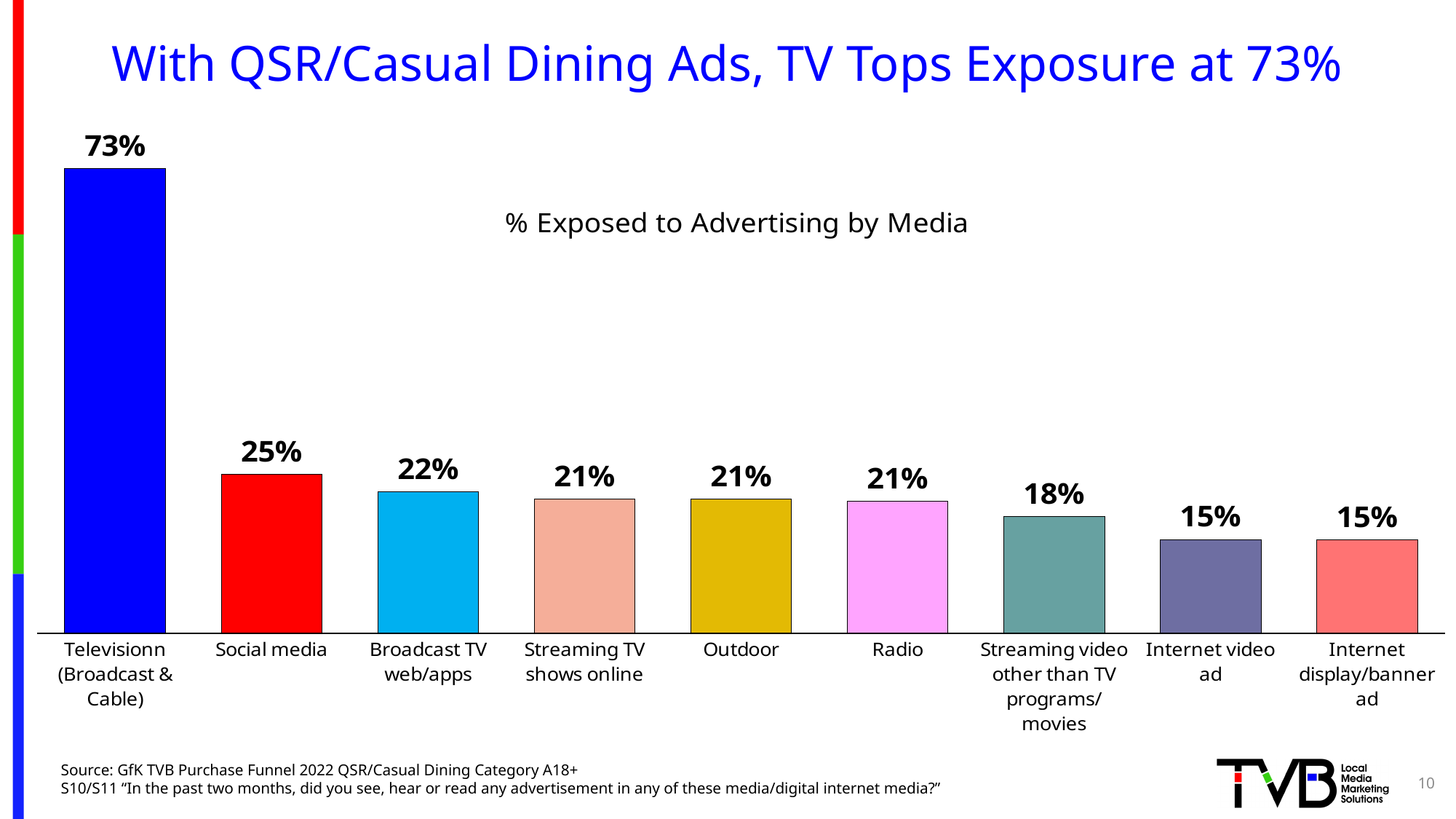
How many media categories are shown in the chart? 9 What percentage is shown for Social media? 25% What colour is the bar for Social media? Red What is the difference between the Televisionn (Broadcast & Cable) value and the Social media value? 48% What is the value for Radio? 21% Which is larger, the value for Social media or the value for Outdoor? Social media What kind of chart is shown on the slide? Bar chart Which media category has the highest exposure value? Televisionn (Broadcast & Cable) What is the title of the chart? % Exposed to Advertising by Media What percentage is shown for Streaming video other than TV programs/movies? 18% Do the values generally rise or fall moving from left to right across the categories? Fall What is the difference between the Broadcast TV web/apps value and the Internet video ad value? 7%